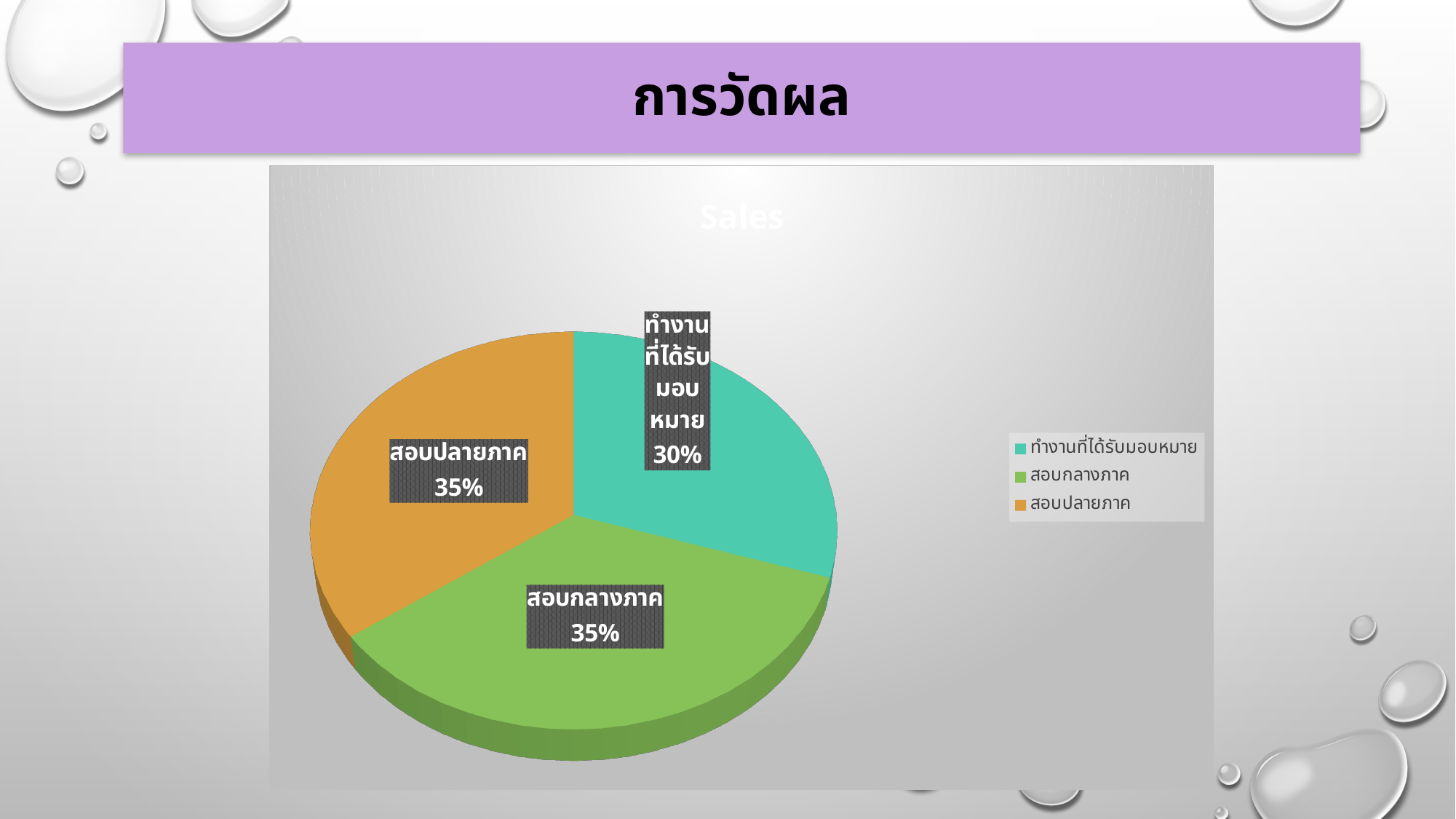
What kind of chart is shown on the slide? pie chart What share of the pie does สอบกลางภาค take? 35% Which is larger, the share for สอบกลางภาค or the share for ทำงานที่ได้รับมอบหมาย? สอบกลางภาค How many slices does the pie chart have? 3 Which colour represents สอบปลายภาค in the pie chart? orange What share of the pie does สอบปลายภาค take? 35% Is the share for ทำงานที่ได้รับมอบหมาย greater or less than the share for สอบปลายภาค? less What is the chart's title? Sales What is the difference between the share for สอบปลายภาค and the share for ทำงานที่ได้รับมอบหมาย? 5% What share of the pie does ทำงานที่ได้รับมอบหมาย take? 30% Which slice of the pie is the smallest? ทำงานที่ได้รับมอบหมาย How many entries does the legend list? 3